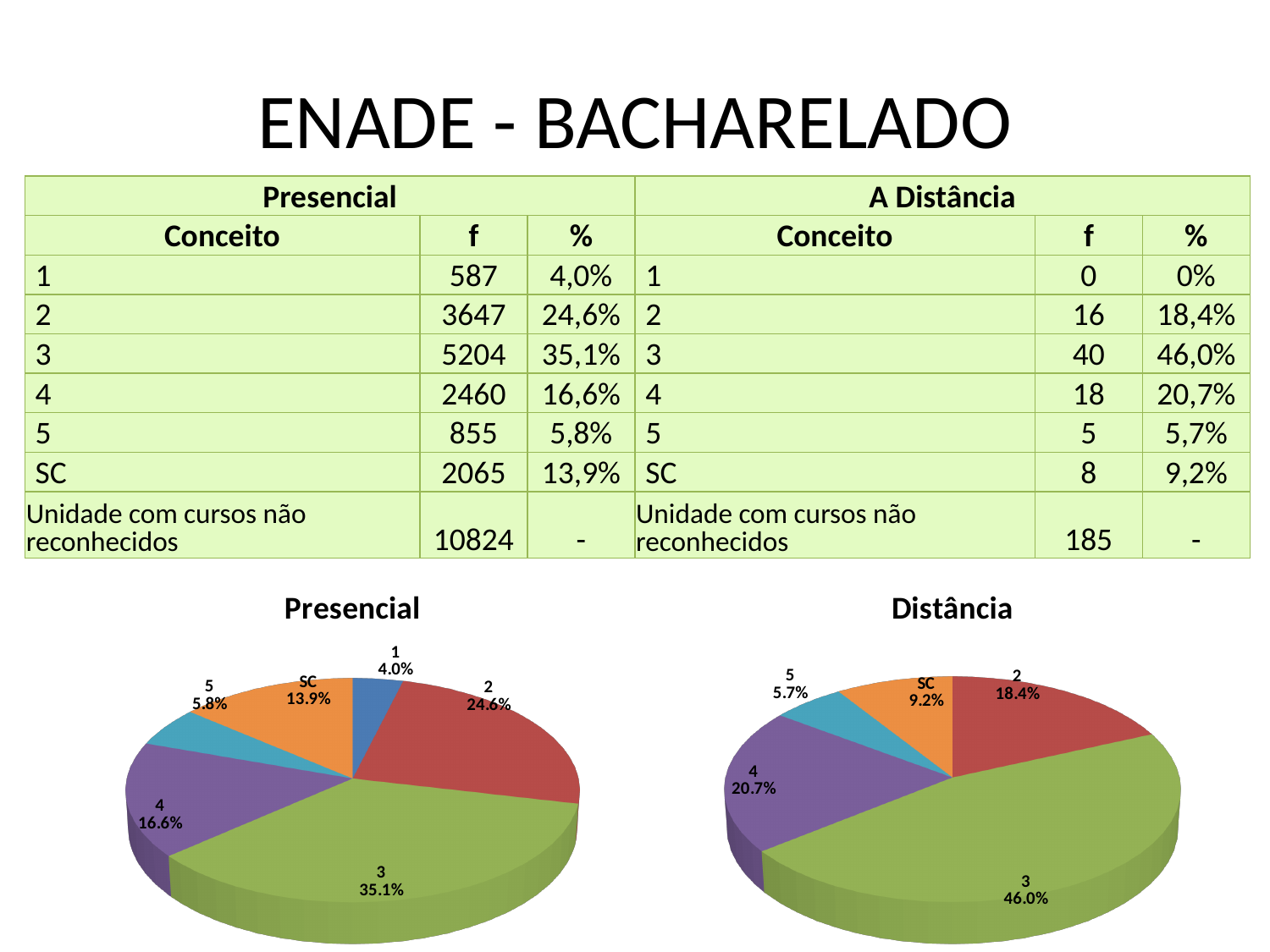
In the Presencial pie chart, which is larger: the slice for category 2 or the slice for category 4? 2 In the Distância pie chart, which category has the smallest slice? 5 In the Presencial pie chart, which category has the smallest slice? 1 In the Distância pie chart, what is the difference between the shares of category 3 and category 2? 27.6% How many slices does the Presencial pie chart have? 6 In the Presencial pie chart, which category has the largest slice? 3 How many slices does the Distância pie chart have? 5 In the Presencial pie chart, what share is shown for category 3? 35.1% In the Presencial pie chart, what share is shown for SC? 13.9% What kind of chart is the Distância chart? Pie chart What is the title of the pie chart on the right side of the slide? Distância In the Distância pie chart, what share is shown for category 4? 20.7%